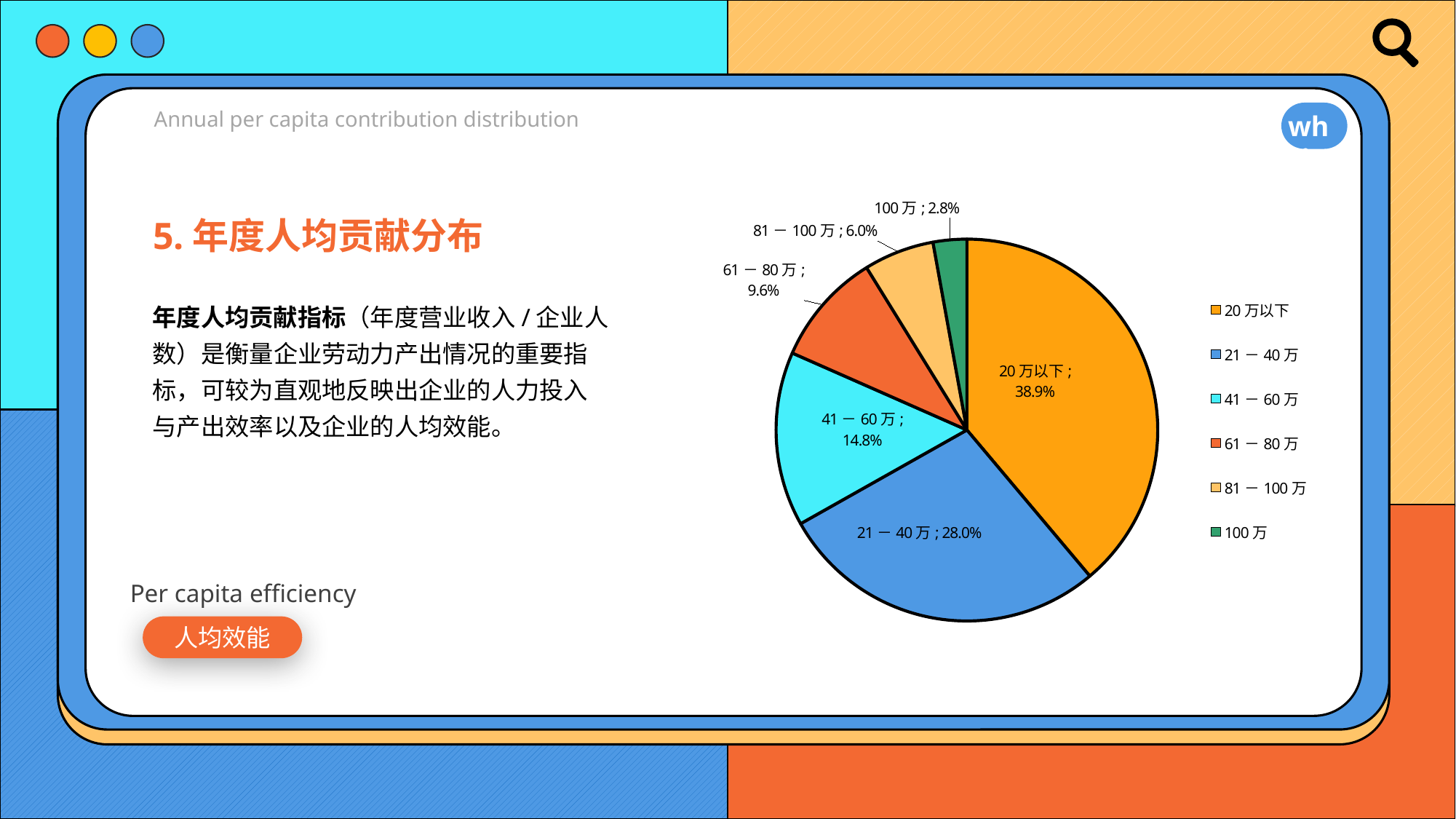
Which slice is larger, 41－60万 or 61－80万? 41－60万 What kind of chart is shown on the slide? pie chart What percentage is shown for the 100万 slice? 2.8% What percentage is shown for the 41－60万 slice? 14.8% What is the difference in percentage points between the 20万以下 slice and the 21－40万 slice? 10.9 Which category has the smallest share of the pie? 100万 What percentage is shown for the 61－80万 slice? 9.6% How many slices does the pie chart have? 6 What percentage is shown for the 21－40万 slice? 28.0% Which category has the largest share of the pie? 20万以下 What share of the pie does the 20万以下 slice represent? 38.9% What percentage is shown for the 81－100万 slice? 6.0%